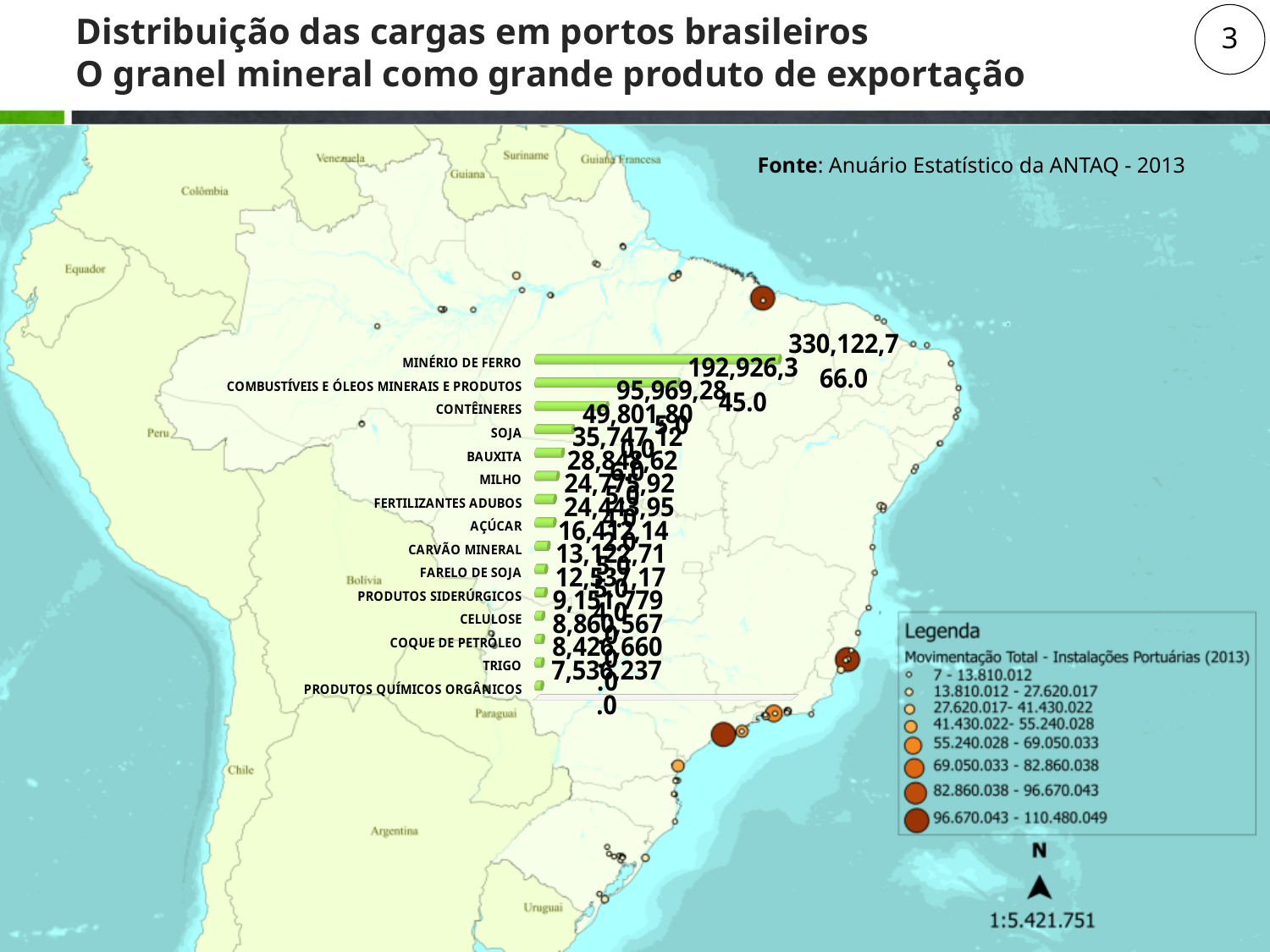
Which has a larger value, MINÉRIO DE FERRO or COMBUSTÍVEIS E ÓLEOS MINERAIS E PRODUTOS? MINÉRIO DE FERRO Which has a larger value, BAUXITA or TRIGO? BAUXITA Which has a larger value, CONTÊINERES or SOJA? CONTÊINERES What kind of chart is overlaid on the map of Brazil? Bar chart How many cargo categories are listed in the bar chart? 15 Which category is listed second in the bar chart, directly below MINÉRIO DE FERRO? COMBUSTÍVEIS E ÓLEOS MINERAIS E PRODUTOS Do the bar values increase or decrease going from the top category to the bottom category? Decrease Which cargo category has the shortest bar in the chart? PRODUTOS QUÍMICOS ORGÂNICOS Which cargo category has the longest bar in the chart? MINÉRIO DE FERRO What source is cited for the data on the slide? Anuário Estatístico da ANTAQ - 2013